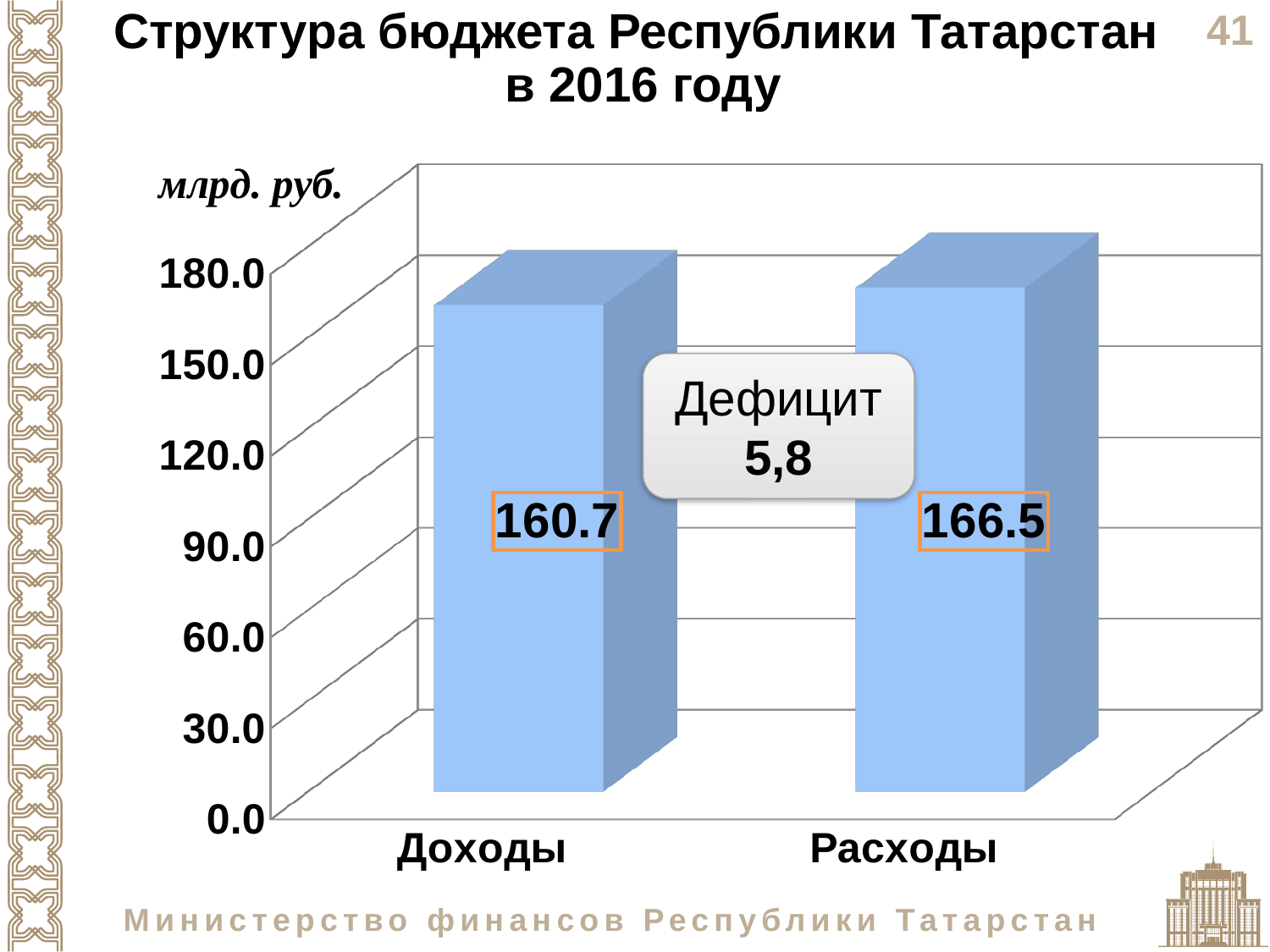
What is the title of the slide? Структура бюджета Республики Татарстан в 2016 году What is the value for Доходы? 160.7 What is the difference between Расходы and Доходы? 5.8 What kind of chart is shown on the slide? bar chart Is the value for Расходы greater or less than 180.0? less Which category has the lowest value? Доходы Which category has the higher value, Доходы or Расходы? Расходы Is the value for Доходы greater or less than 150.0? greater What is the value for Расходы? 166.5 How many categories are shown on the chart? 2 What deficit value is shown in the callout on the chart? 5,8 What unit is indicated for the values on the chart? млрд. руб.